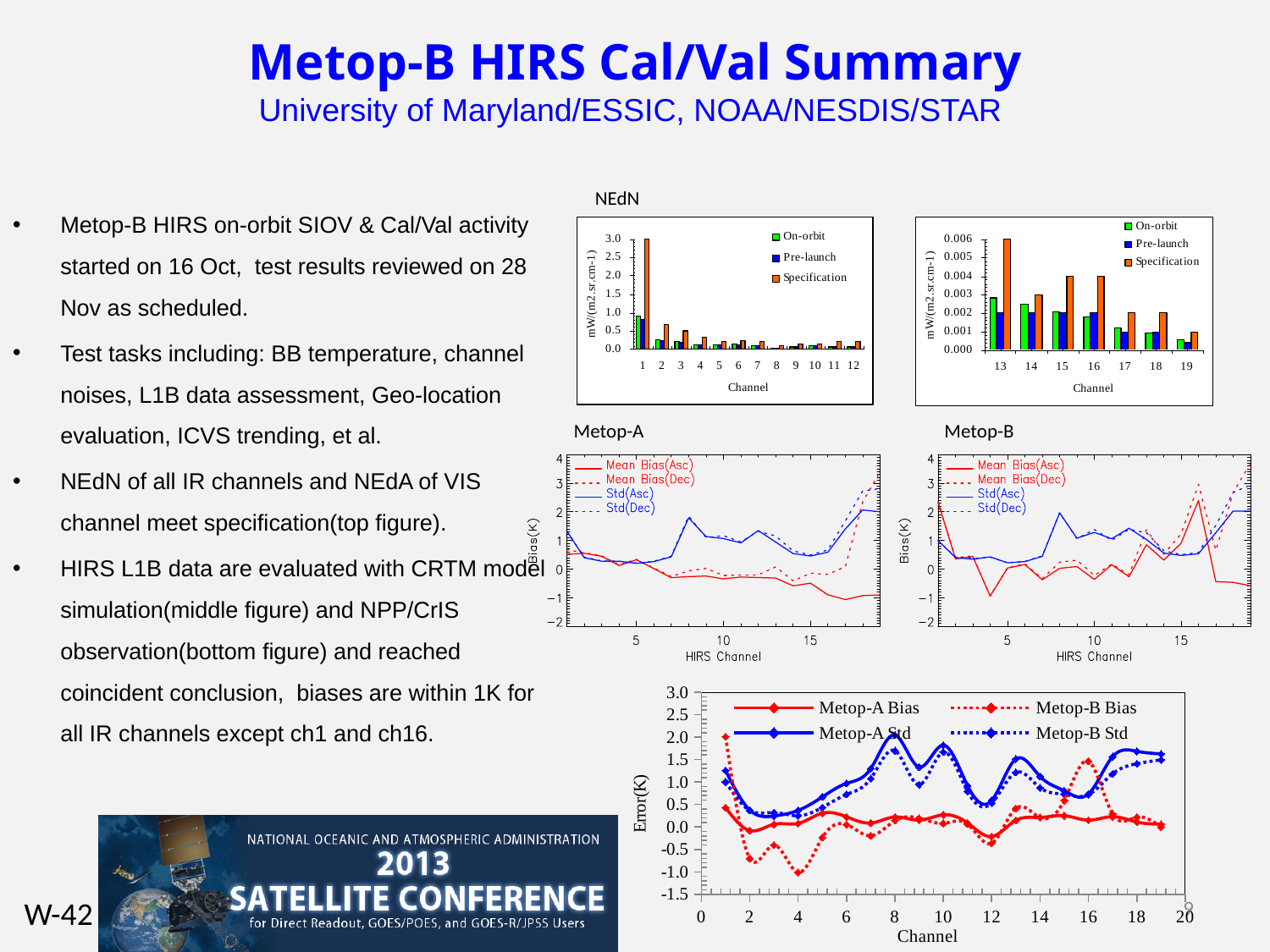
In the NEdN chart for channels 13 to 19 (top right), which channel has the highest Specification value? 13 In the NEdN chart for channels 13 to 19 (top right), is the Specification value for channel 13 greater or less than 0.005? greater In the NEdN chart for channels 1 to 12 (top left), how many series does the legend list? 3 In the Metop-B chart (middle right), what is the label of the x axis? HIRS Channel In the bottom chart with Error(K) on the y axis, what kind of chart is shown? line chart In the Metop-A chart (middle left), how many series does the legend list? 4 In the bottom chart with Error(K) on the y axis, is the Metop-A Std value at channel 8 greater or less than 1.5? greater In the NEdN chart for channels 1 to 12 (top left), is the Specification value for channel 1 greater or less than 2.5? greater In the NEdN chart for channels 13 to 19 (top right), how many channels are plotted on the x axis? 7 In the NEdN chart for channels 1 to 12 (top left), which channel has the highest Specification value? 1 In the NEdN chart for channels 1 to 12 (top left), what kind of chart is shown? bar chart